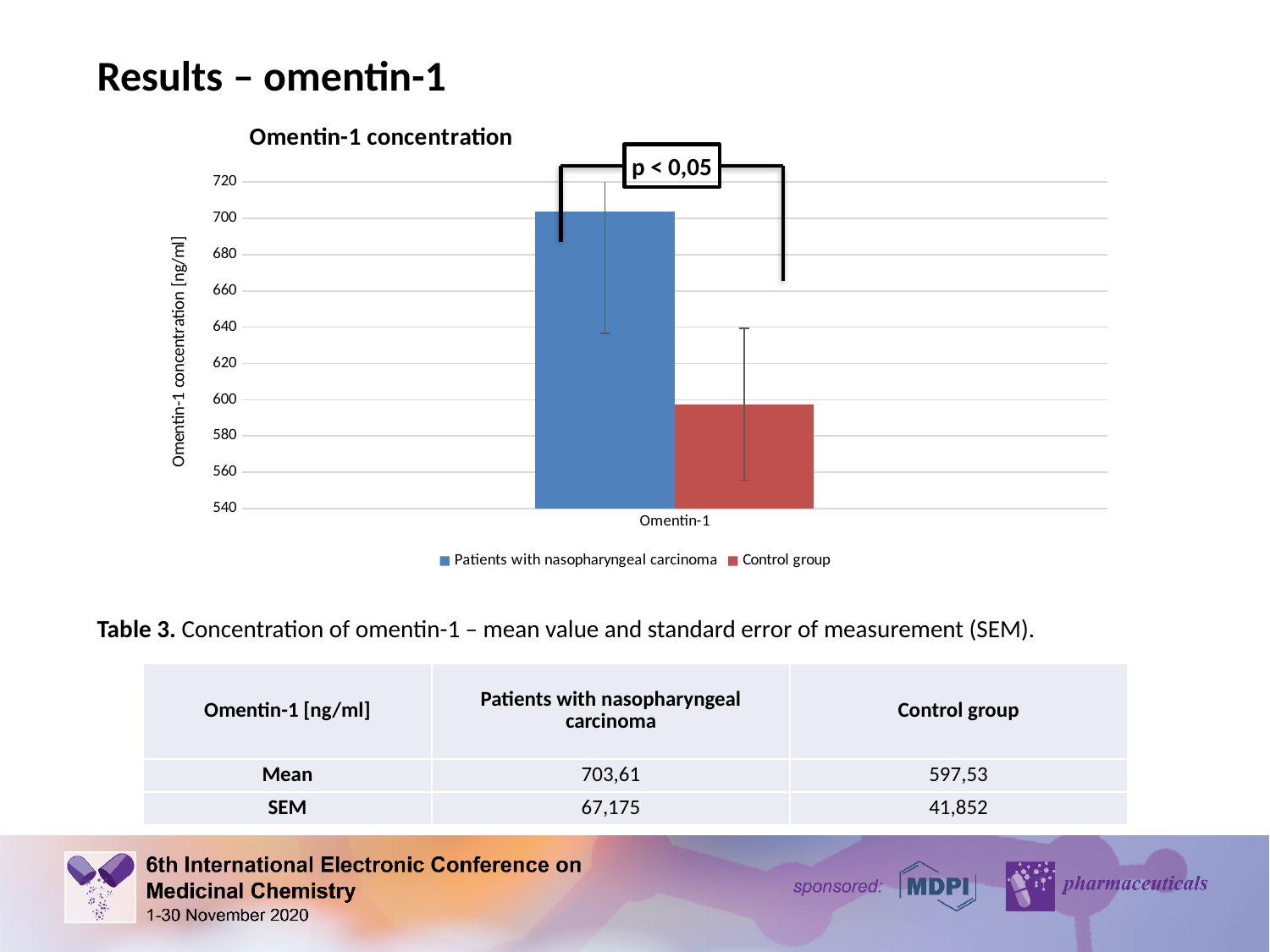
Is the omentin-1 concentration for the Control group greater or less than 600? less What is the title of the chart? Omentin-1 concentration Is the bar for Patients with nasopharyngeal carcinoma larger or smaller than the bar for the Control group? larger What is the mean omentin-1 concentration for Patients with nasopharyngeal carcinoma, as given on the slide? 703,61 Which group has the higher omentin-1 concentration in the chart? Patients with nasopharyngeal carcinoma What is the y-axis label of the chart? Omentin-1 concentration [ng/ml] Which group has the lower omentin-1 concentration in the chart? Control group Is the omentin-1 concentration for Patients with nasopharyngeal carcinoma greater or less than 700? greater How many series does the chart legend list? 2 What type of chart is shown on the slide? bar chart What is the mean omentin-1 concentration for the Control group, as given on the slide? 597,53 What is the difference between the mean omentin-1 concentration of Patients with nasopharyngeal carcinoma and the Control group? 106,08